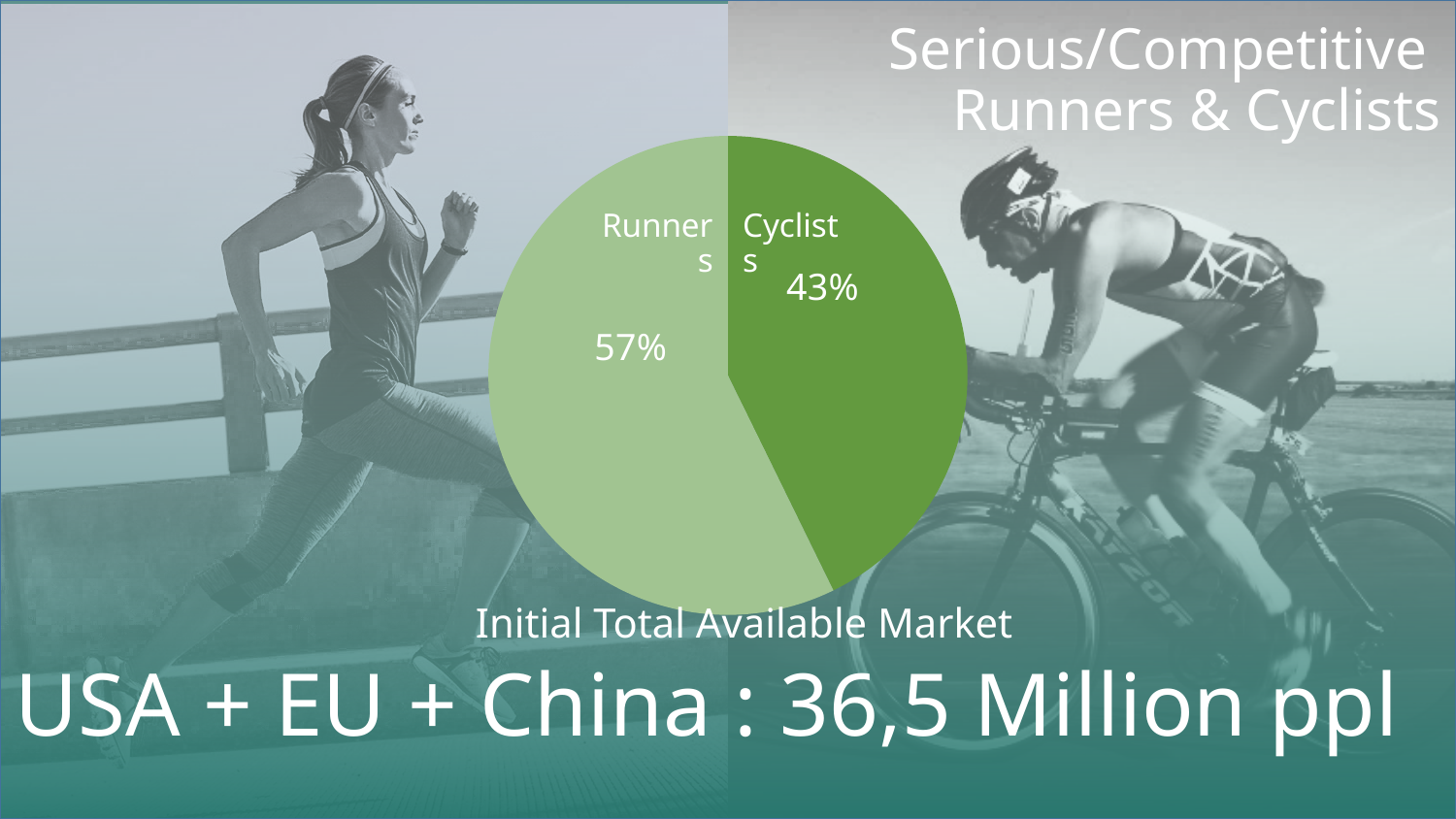
Is the Cyclists slice greater or less than 50% of the pie? less What kind of chart is shown on the slide? pie chart Which slice of the pie chart is the largest? Runners Which is larger in the pie chart, Runners or Cyclists? Runners What total available market figure is stated below the chart for USA + EU + China? 36,5 Million ppl How many slices does the pie chart have? 2 What is the difference in percentage points between the Runners and Cyclists slices? 14 What percentage of the pie chart is Cyclists? 43% What is the share of the pie taken by the Runners slice? 57% What percentage of the pie chart is Runners? 57% What is the title shown at the top right of the slide above the chart? Serious/Competitive Runners & Cyclists Which slice of the pie chart is the smallest? Cyclists